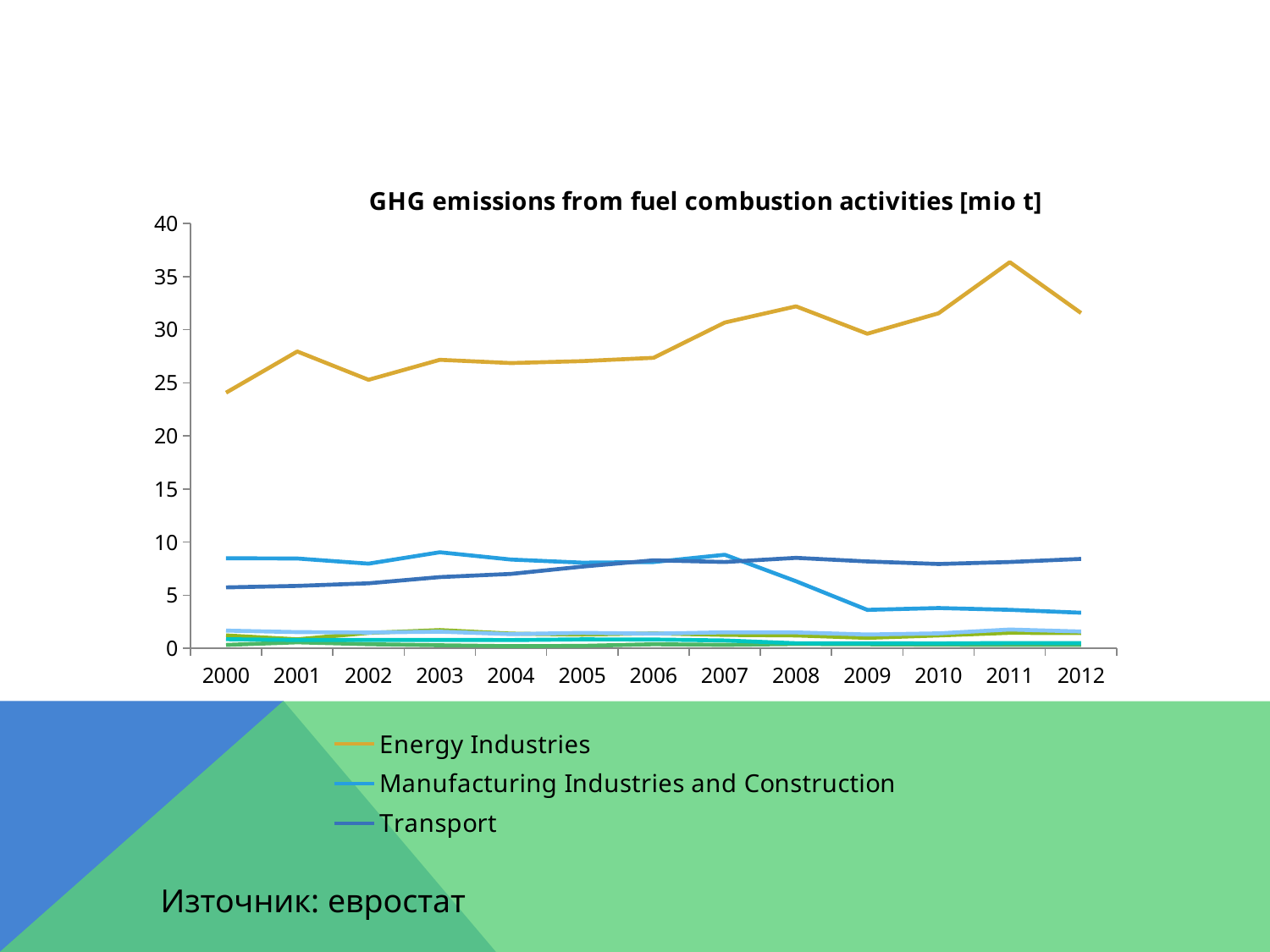
What is the title of the chart? GHG emissions from fuel combustion activities [mio t] In which year does the Energy Industries series reach its highest value? 2011 Does the Manufacturing Industries and Construction series rise or fall between 2007 and 2009? fall Which series has the larger value in 2012, Manufacturing Industries and Construction or Transport? Transport Is the value for Manufacturing Industries and Construction in 2009 greater or less than 5? less How many years are shown on the x axis? 13 Which series has the larger value in 2000, Manufacturing Industries and Construction or Transport? Manufacturing Industries and Construction In which year does the Energy Industries series have its lowest value? 2000 Is the value for Energy Industries in 2000 greater or less than 25? less How many series does the legend list? 3 What kind of chart is shown on the slide? line chart Is the value for Energy Industries in 2011 greater or less than 35? greater